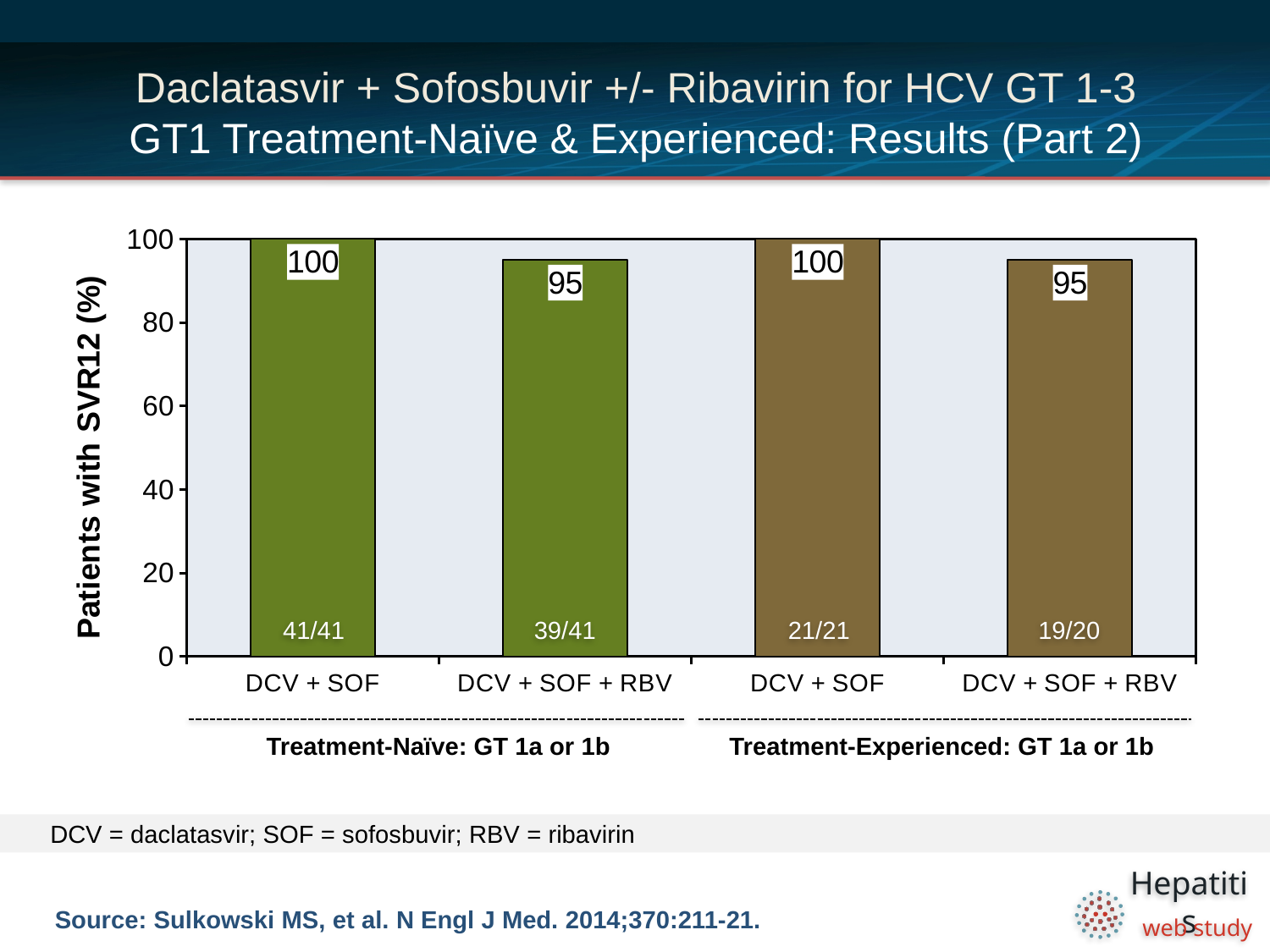
What is the difference in SVR12 rate between DCV + SOF and DCV + SOF + RBV in the Treatment-Naïve group? 5 Which regimen has the higher SVR12 rate in the Treatment-Experienced group, DCV + SOF or DCV + SOF + RBV? DCV + SOF What is the maximum value shown on the y-axis? 100 What is the SVR12 rate for DCV + SOF in the Treatment-Naïve: GT 1a or 1b group? 100 How many bars are shown in the chart? 4 How many patients achieved SVR12 with DCV + SOF + RBV in the Treatment-Naïve group, as shown by the fraction on the bar? 39/41 What fraction is printed on the DCV + SOF + RBV bar in the Treatment-Experienced group? 19/20 What fraction is printed on the DCV + SOF bar in the Treatment-Experienced group? 21/21 Is the SVR12 rate for DCV + SOF + RBV in the Treatment-Naïve group greater or less than 80? greater What type of chart is shown on the slide? bar chart What is the label of the y-axis? Patients with SVR12 (%) What is the SVR12 rate for DCV + SOF + RBV in the Treatment-Experienced: GT 1a or 1b group? 95